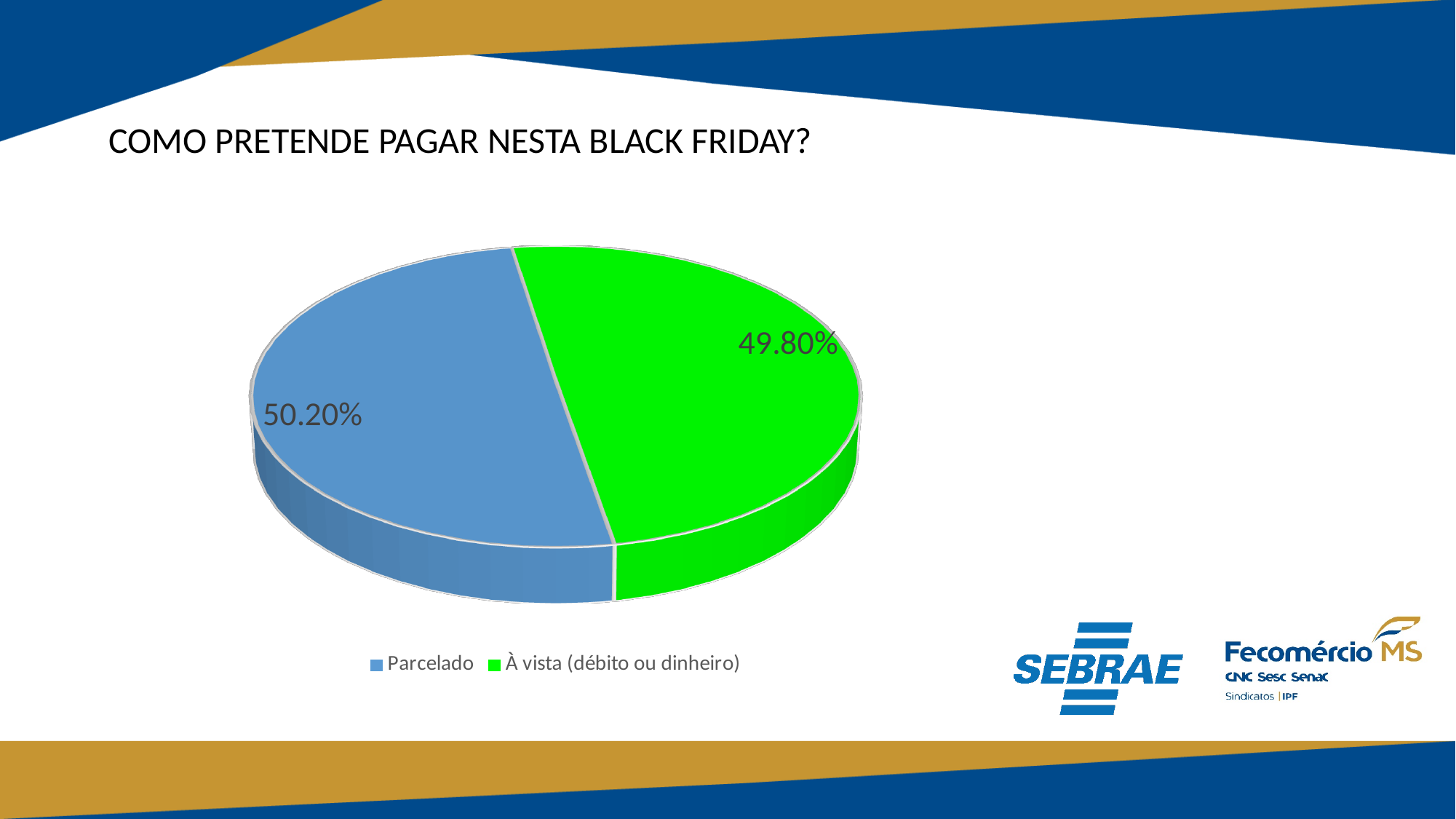
How many slices does the pie chart have? 2 How many entries does the legend list? 2 What percentage of respondents chose Parcelado? 50.20% What is the title of the chart on the slide? COMO PRETENDE PAGAR NESTA BLACK FRIDAY? What percentage of respondents chose À vista (débito ou dinheiro)? 49.80% What colour is the Parcelado slice? blue What kind of chart is shown on the slide? pie chart Which is larger, the share for Parcelado or the share for À vista (débito ou dinheiro)? Parcelado Which payment option has the smaller share of the pie? À vista (débito ou dinheiro) Which payment option has the larger share of the pie? Parcelado What is the combined share of the two slices in the pie chart? 100% What is the difference in percentage points between the Parcelado and À vista (débito ou dinheiro) slices? 0.40%